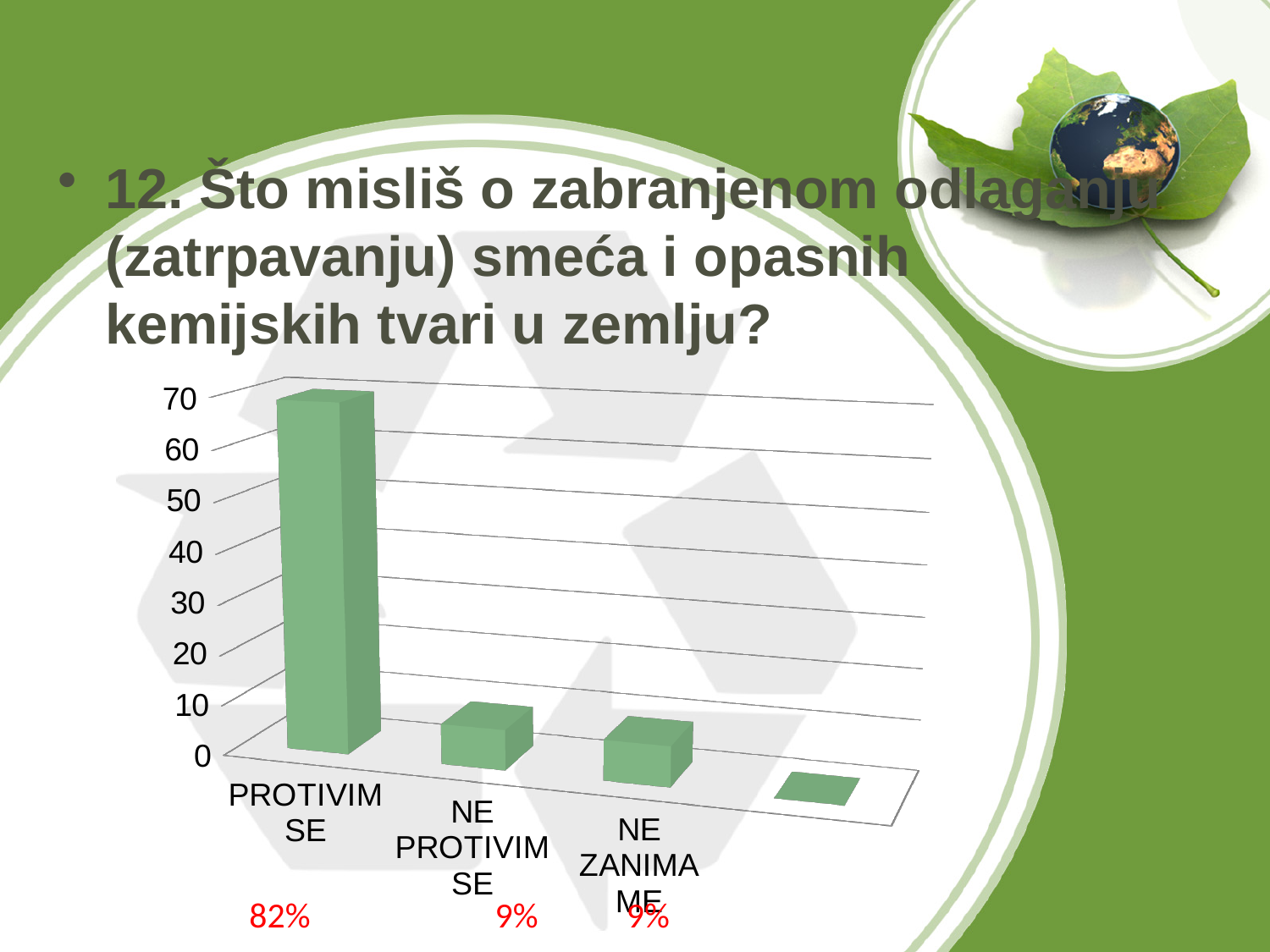
Which category has the tallest bar? PROTIVIM SE What percentage is shown for NE ZANIMA ME? 9% What kind of chart is shown on the slide? bar chart What percentage is shown for NE PROTIVIM SE? 9% Is the value for PROTIVIM SE greater or less than 60? greater What is the difference between the percentages shown for PROTIVIM SE and NE PROTIVIM SE? 73% Which is larger, the bar for PROTIVIM SE or the bar for NE ZANIMA ME? PROTIVIM SE What percentage is shown for PROTIVIM SE? 82% Is the value for NE PROTIVIM SE greater or less than 20? less What is the highest value shown on the vertical axis? 70 Do the bar heights rise or fall from left to right across the chart? fall Is the value for NE ZANIMA ME greater or less than 20? less